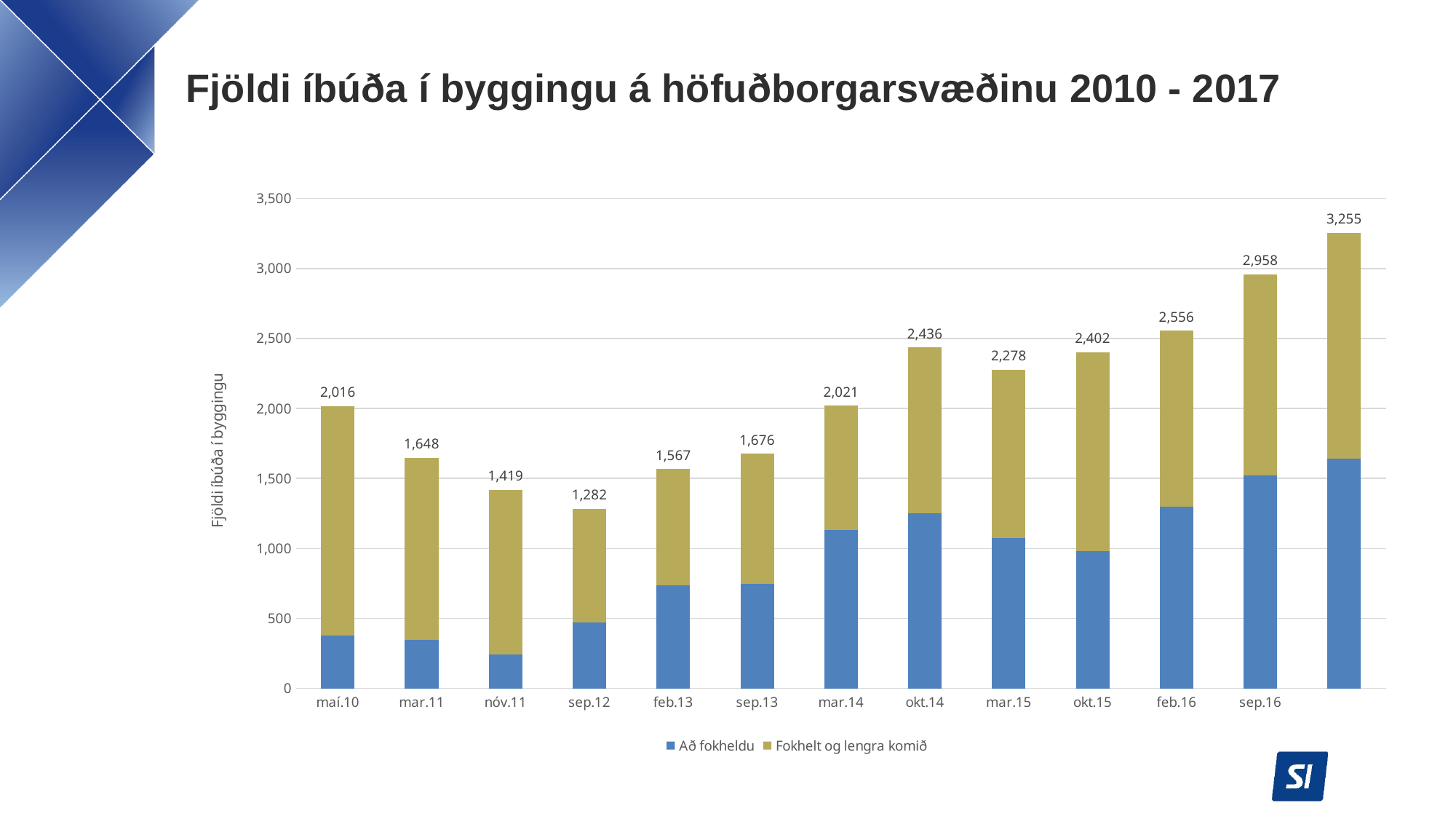
Is the 'Að fokheldu' value for feb.16 greater or less than 1,000? greater What is the total number of apartments under construction shown for maí.10? 2,016 What kind of chart is shown on the slide? Stacked bar chart How many bars are plotted on the chart? 13 What is the highest total value labelled on the chart? 3,255 Which labelled period has the lowest total? sep.12 What is the total value labelled for sep.16? 2,958 What is the difference between the totals for sep.16 and feb.16? 402 Which has the larger total, mar.15 or okt.15? okt.15 What is the total value labelled above the bar for okt.14? 2,436 How many series does the legend list? 2 Is the 'Að fokheldu' value for maí.10 greater or less than 500? less